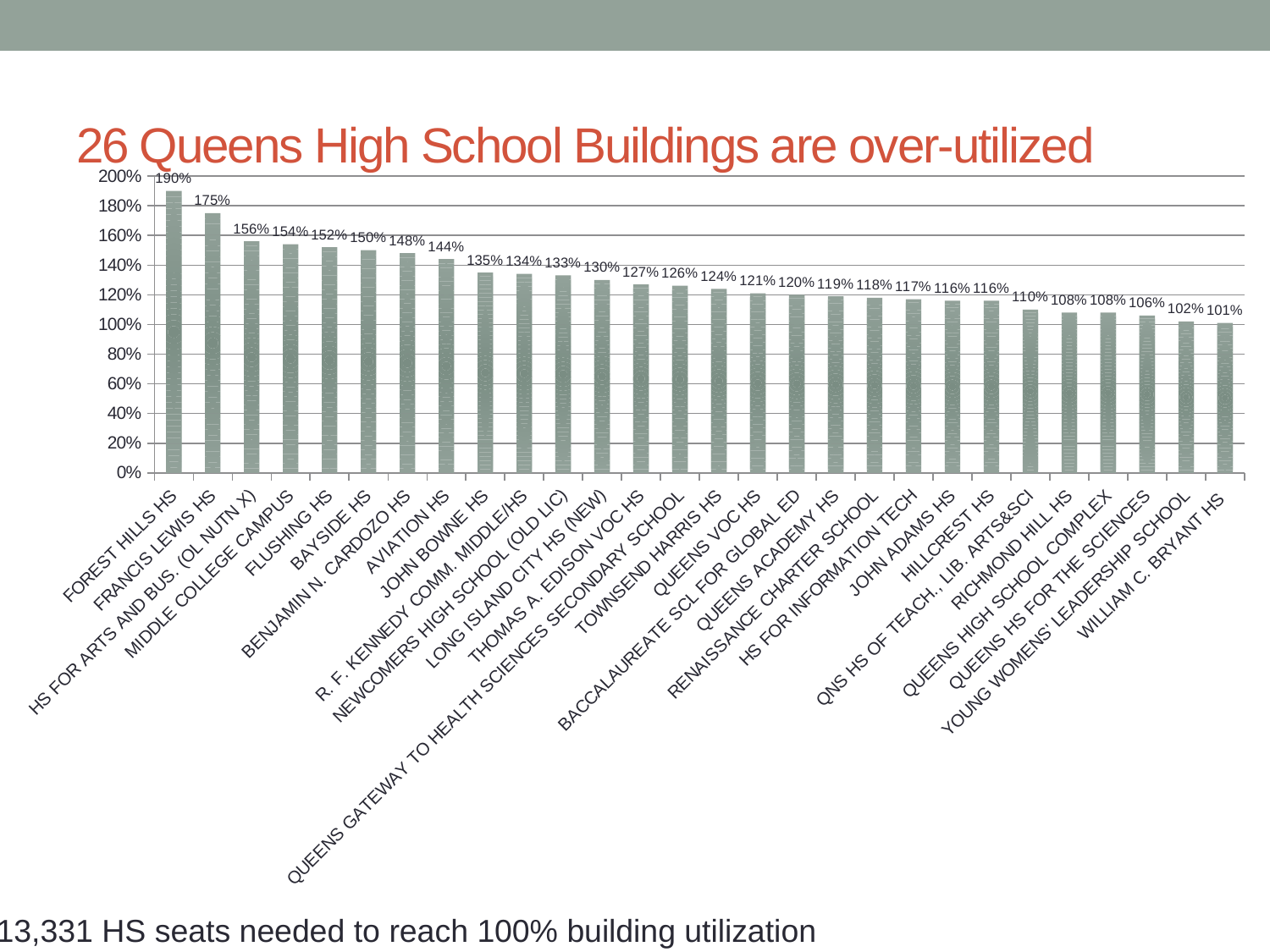
How many schools are shown in the chart? 28 What is the utilization value for RICHMOND HILL HS? 108% What is the title of the chart? 26 Queens High School Buildings are over-utilized What is the utilization value for TOWNSEND HARRIS HS? 124% What is the utilization value for FOREST HILLS HS? 190% What is the difference between the utilization values for FOREST HILLS HS and FRANCIS LEWIS HS? 15% What kind of chart is shown on the slide? Bar chart Which school has the highest utilization value? FOREST HILLS HS Which school has the lowest utilization value? WILLIAM C. BRYANT HS Which has a higher utilization value, BAYSIDE HS or AVIATION HS? BAYSIDE HS Do the values rise or fall from left to right along the x axis? Fall Is the value for JOHN BOWNE HS greater or less than 120%? greater